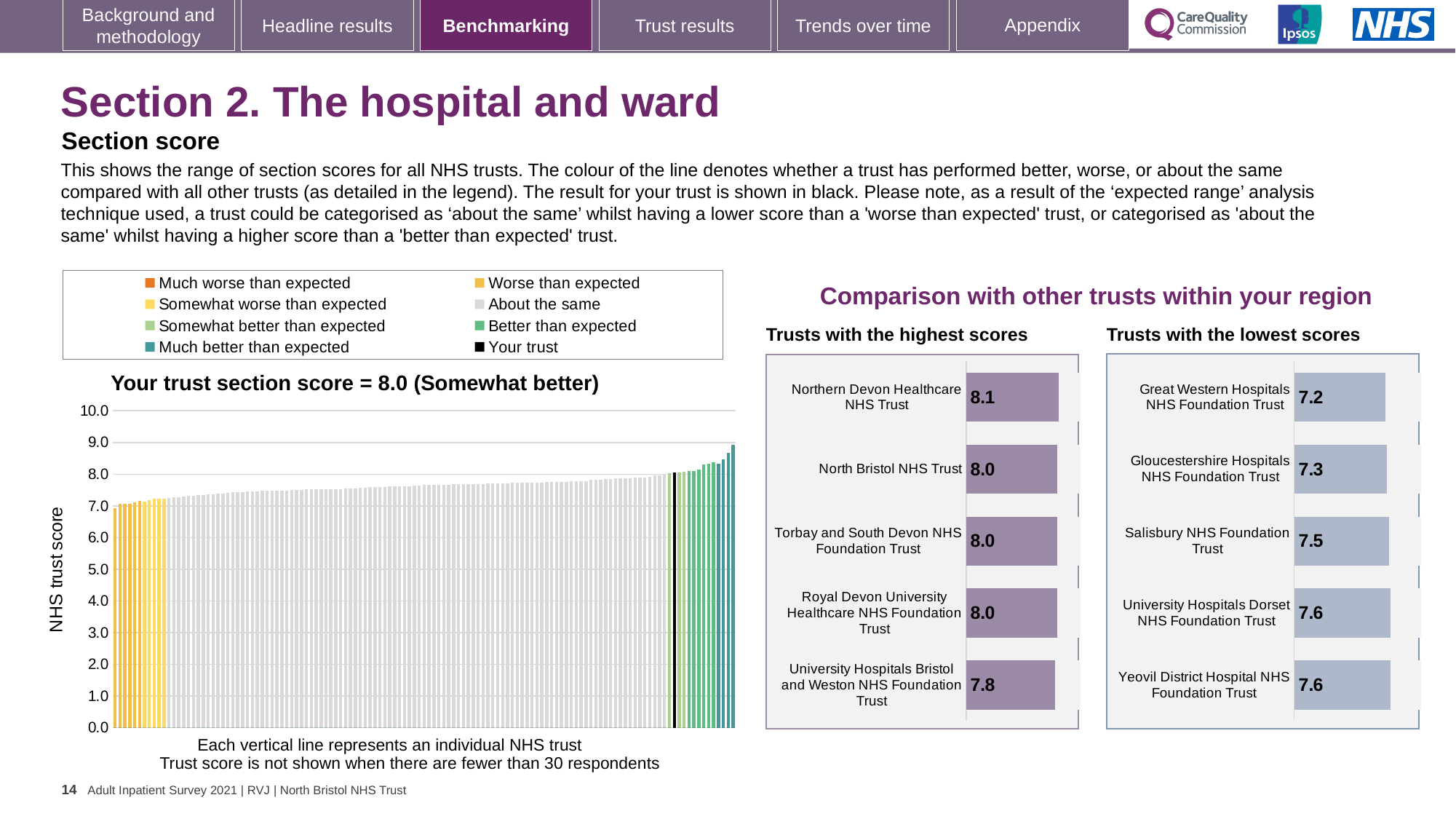
In the large chart on the left, do the trust scores rise or fall from left to right along the x axis? Rise How many entries does the legend above the large chart on the left list? 8 In the 'Trusts with the lowest scores' chart, what is the score for Great Western Hospitals NHS Foundation Trust? 7.2 In the 'Trusts with the highest scores' chart, what is the difference between the scores of Northern Devon Healthcare NHS Trust and University Hospitals Bristol and Weston NHS Foundation Trust? 0.3 In the 'Trusts with the lowest scores' chart, which trust has the lowest score? Great Western Hospitals NHS Foundation Trust In the 'Trusts with the highest scores' chart, what is the score for Northern Devon Healthcare NHS Trust? 8.1 In the 'Trusts with the lowest scores' chart, which has the larger score: Gloucestershire Hospitals NHS Foundation Trust or University Hospitals Dorset NHS Foundation Trust? University Hospitals Dorset NHS Foundation Trust In the 'Trusts with the highest scores' chart, which trust has the highest score? Northern Devon Healthcare NHS Trust In the 'Trusts with the highest scores' chart, what is the score for University Hospitals Bristol and Weston NHS Foundation Trust? 7.8 How many trusts are listed in the 'Trusts with the lowest scores' chart? 5 What kind of chart is the large chart on the left showing the range of section scores for all NHS trusts? Bar chart In the 'Trusts with the lowest scores' chart, what is the score for Salisbury NHS Foundation Trust? 7.5